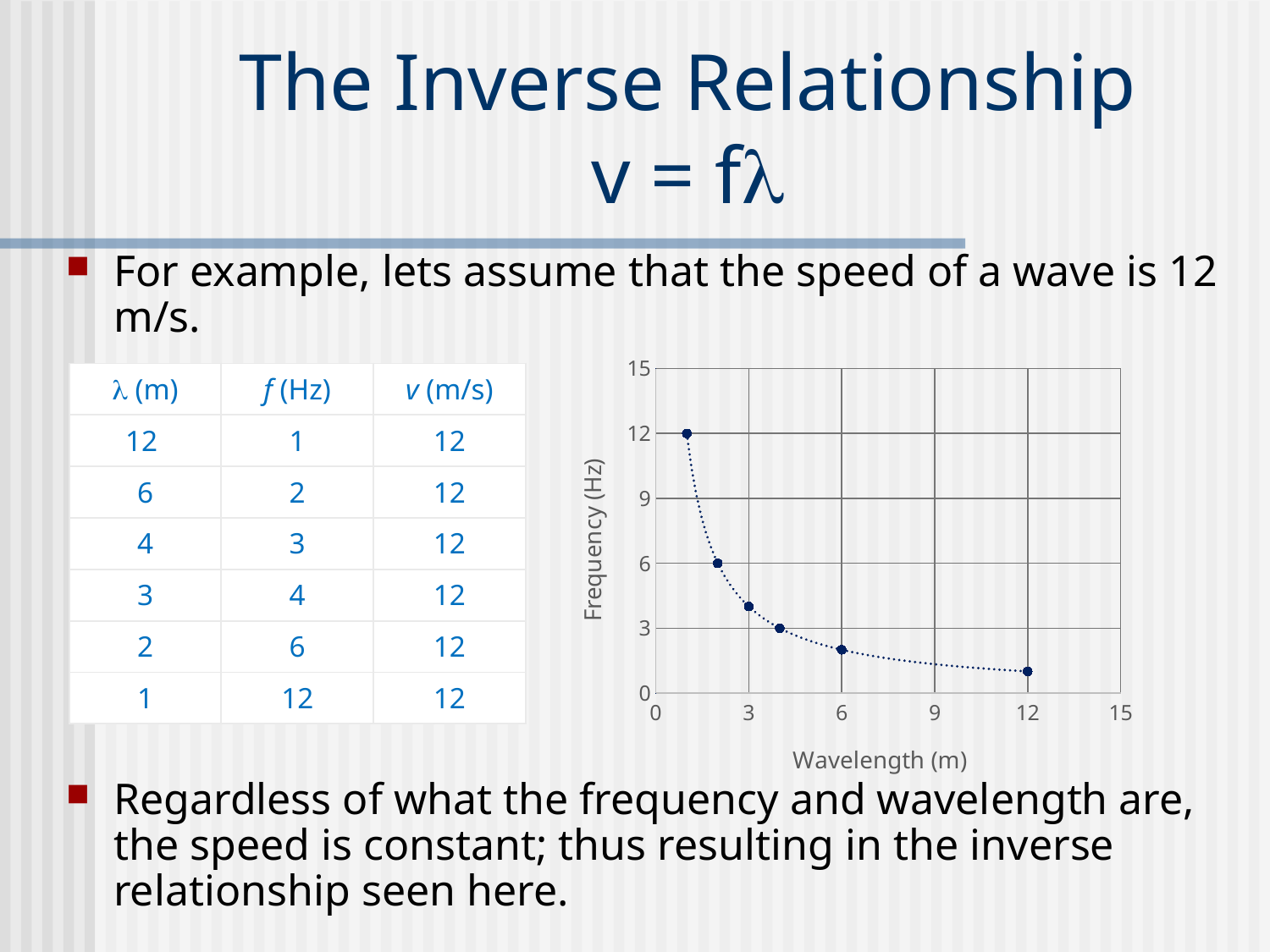
Is the frequency at a wavelength of 12 m greater or less than 3? less What is the frequency plotted at a wavelength of 2 m? 6 What kind of chart is shown on the slide? scatter chart Does frequency rise or fall as wavelength increases along the x axis? fall How many data points are plotted on the chart? 6 What is the frequency plotted at a wavelength of 1 m? 12 Which has the higher frequency: the point at wavelength 2 m or the point at wavelength 6 m? 2 m What is the frequency plotted at a wavelength of 4 m? 3 What is the difference in frequency between the points at wavelength 1 m and wavelength 2 m? 6 At which wavelength is the plotted frequency highest? 1 m At which wavelength is the plotted frequency lowest? 12 m What is the title of the chart's x axis? Wavelength (m)